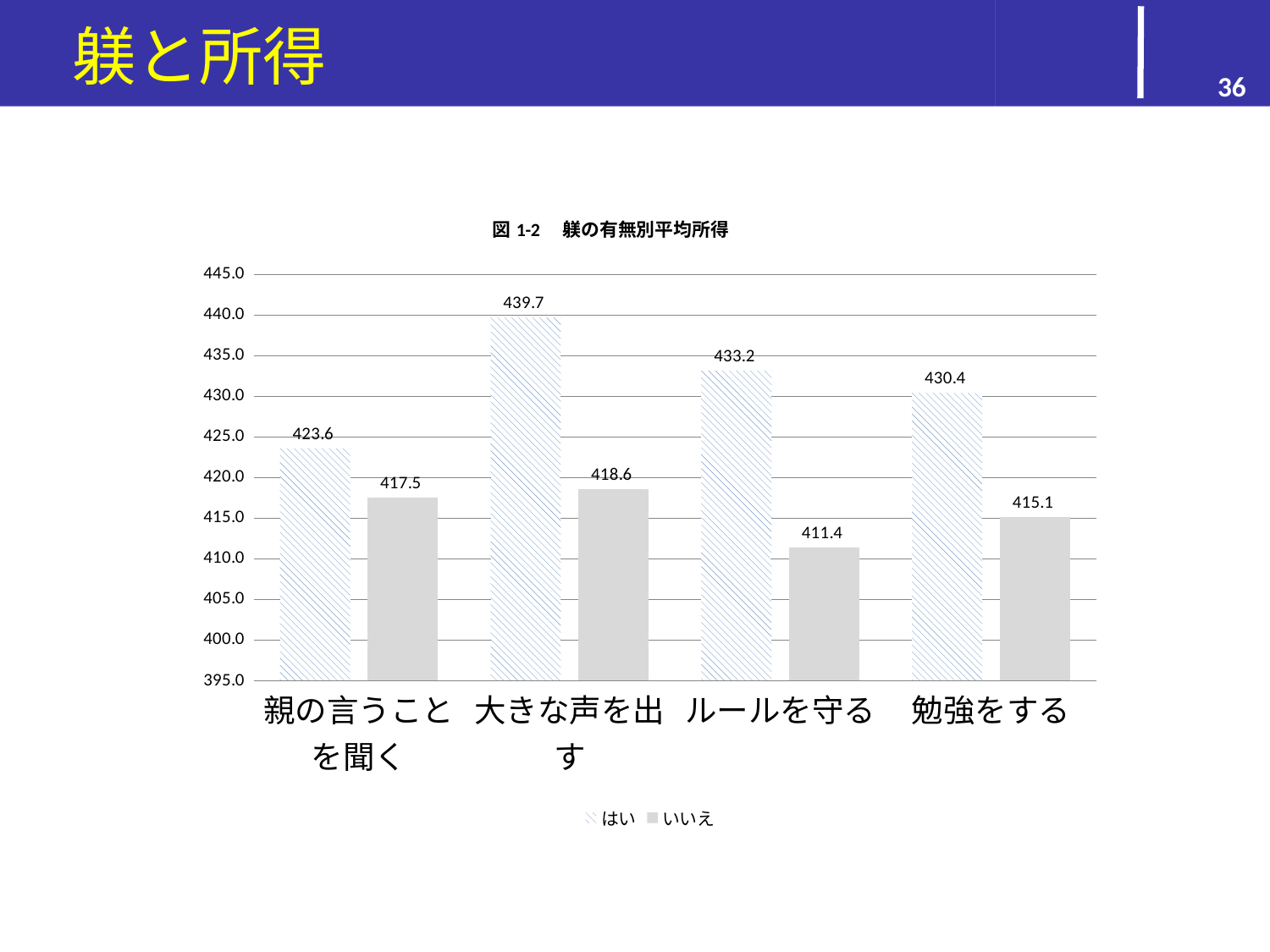
Is the いいえ value for 勉強をする greater or less than 420.0? less How many series does the legend list? 2 Which category has the lowest いいえ value? ルールを守る What is the title of the chart? 図 1-2 躾の有無別平均所得 Which is larger for 親の言うことを聞く: the はい value or the いいえ value? はい What is the value for はい in the 大きな声を出す category? 439.7 What is the value for いいえ in the ルールを守る category? 411.4 How many categories are shown on the x axis? 4 Which category has the highest はい value? 大きな声を出す What is the difference between the はい and いいえ values for ルールを守る? 21.8 What kind of chart is shown? bar chart What is the value for はい in the 勉強をする category? 430.4